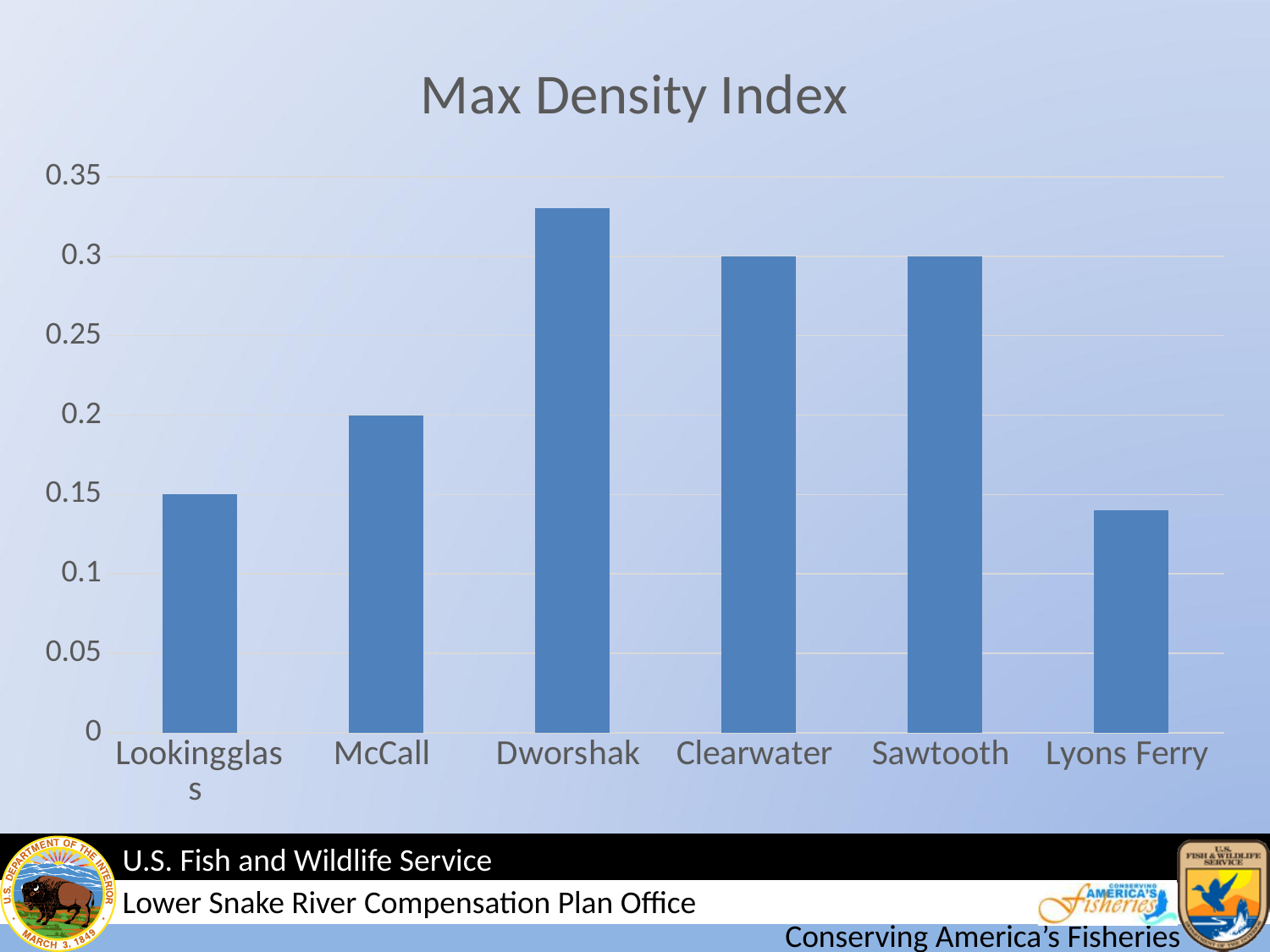
What is the Max Density Index value for Lookingglass? 0.15 What is the Max Density Index value for McCall? 0.2 What kind of chart is shown on the slide? bar chart Which is larger, the value for Dworshak or the value for Clearwater? Dworshak What is the Max Density Index value for Clearwater? 0.3 How many categories are shown on the x axis of the chart? 6 What is the difference between the values for Clearwater and McCall? 0.1 What is the Max Density Index value for Sawtooth? 0.3 Which category has the highest Max Density Index? Dworshak What is the title of the chart? Max Density Index Is the value for Lyons Ferry greater or less than 0.15? less Is the value for Dworshak greater or less than 0.3? greater